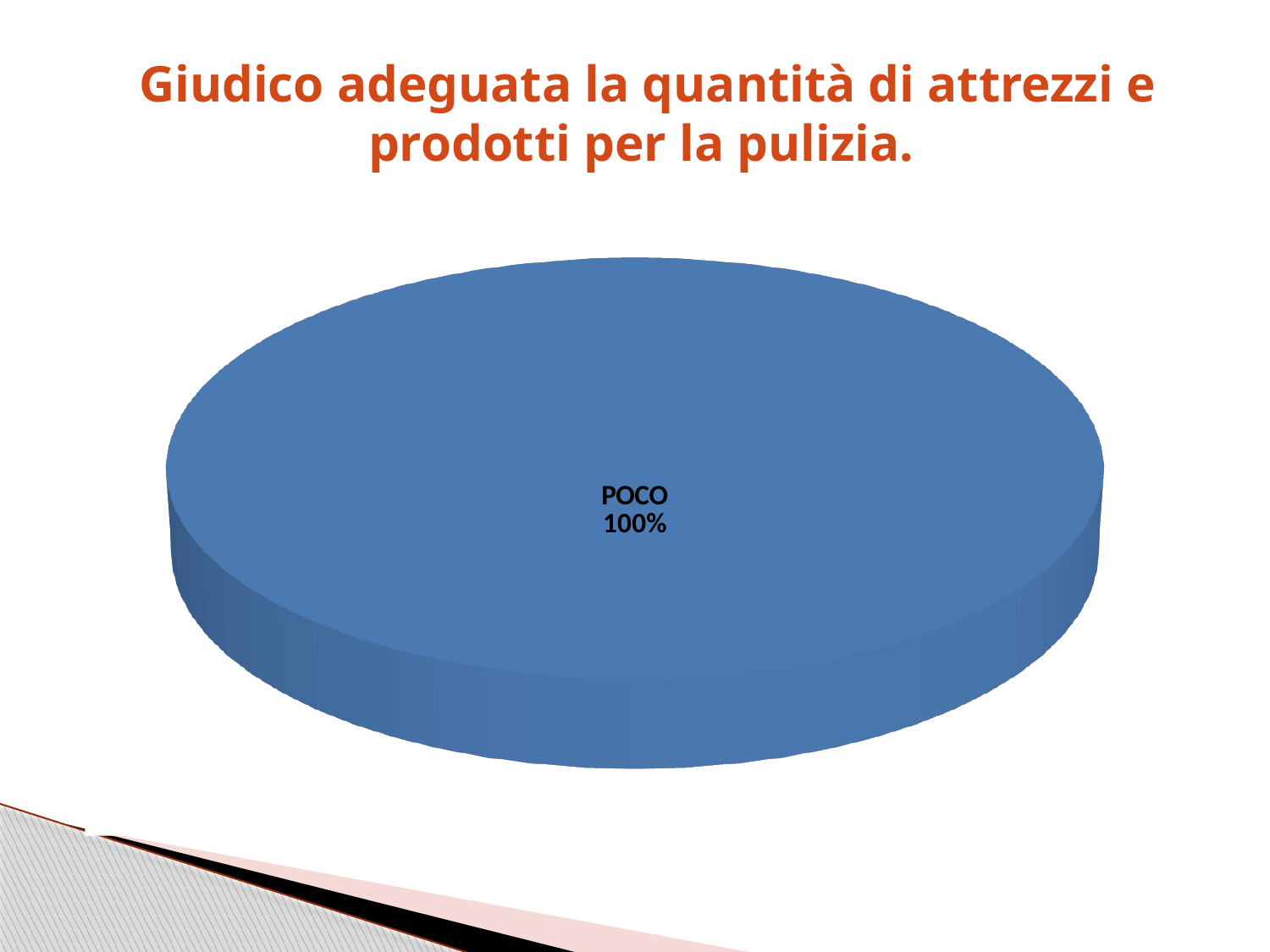
What kind of chart is shown on the slide? pie chart What is the title of the slide above the chart? Giudico adeguata la quantità di attrezzi e prodotti per la pulizia. What colour is the POCO slice of the pie chart? blue What is the label of the only slice in the pie chart? POCO What share of the pie does the POCO slice represent? 100% How many slices does the pie chart have? 1 Which category has the largest share of the pie chart? POCO